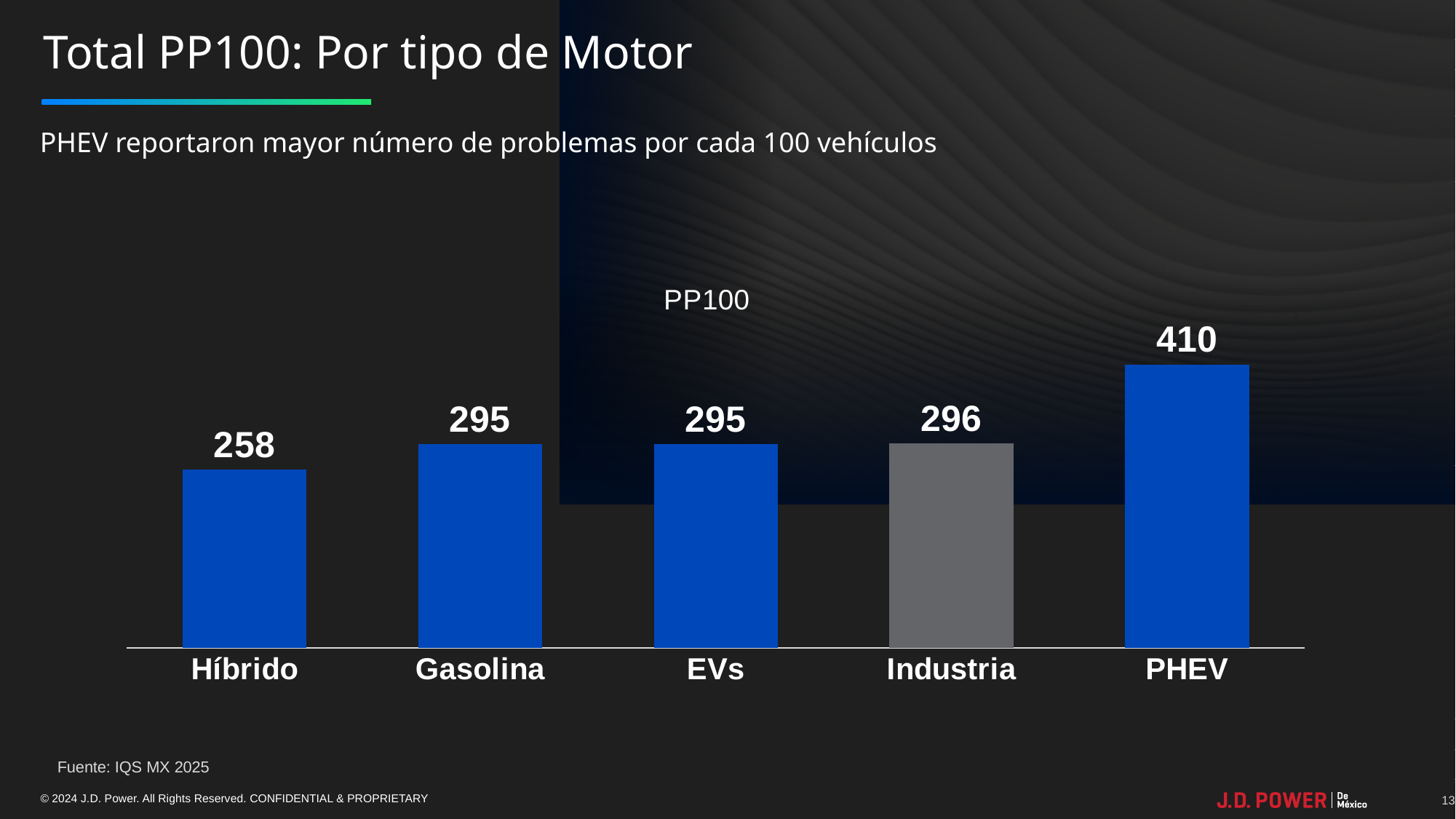
Which bar is shown in grey rather than blue? Industria What is the PP100 value for PHEV? 410 What is the difference between the PP100 values for PHEV and Híbrido? 152 Which has a larger PP100 value, PHEV or EVs? PHEV What is the difference between the PP100 values for Industria and Gasolina? 1 What is the PP100 value for Híbrido? 258 How many categories are shown in the chart? 5 What kind of chart is shown on the slide? Bar chart What is the PP100 value for Industria? 296 Which category has the lowest PP100 value? Híbrido Which category has the highest PP100 value? PHEV What is the PP100 value for Gasolina? 295